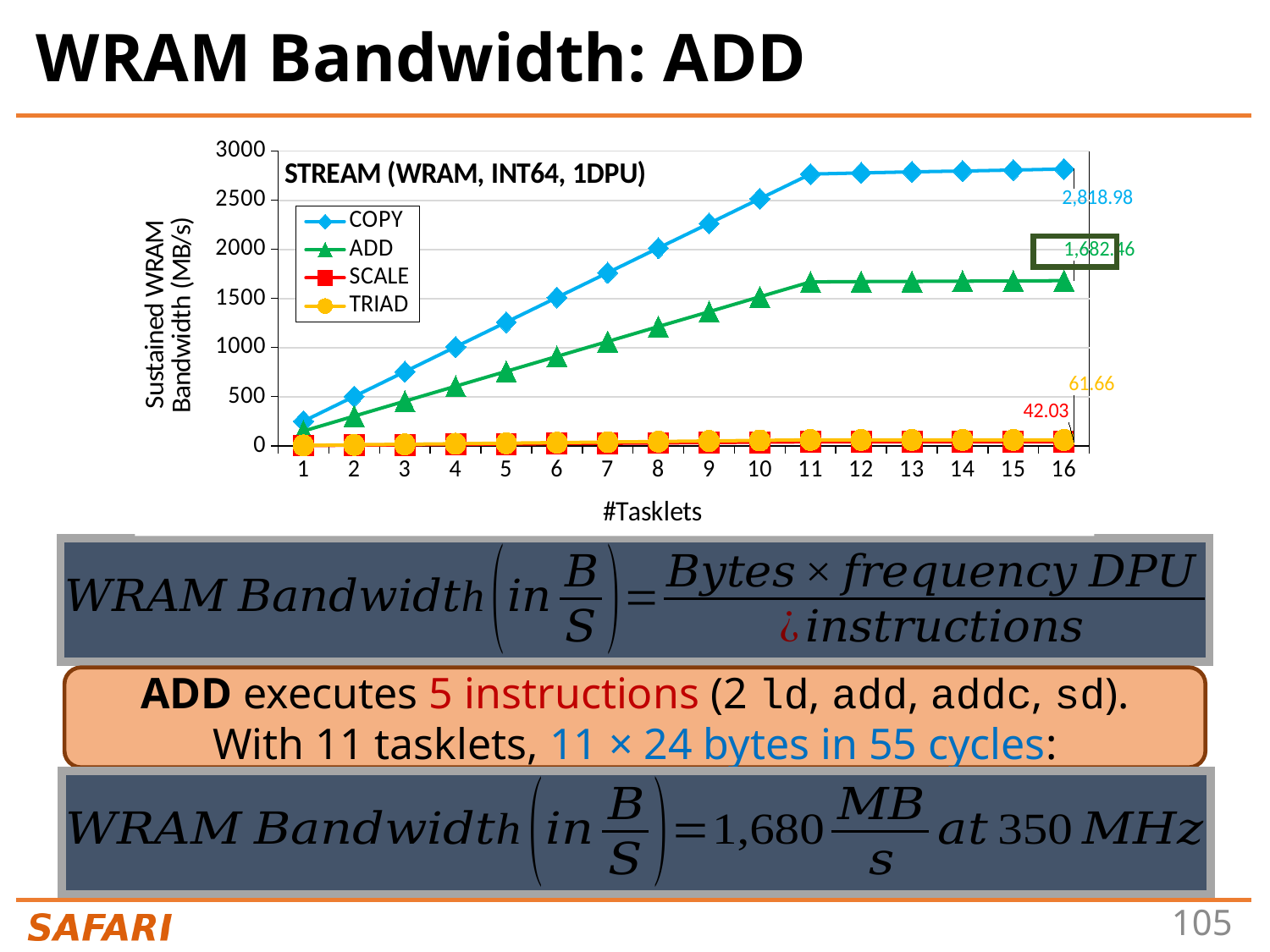
How many series does the chart legend list? 4 What is the COPY bandwidth at 16 tasklets? 2,818.98 How many tasklet counts are plotted on the x axis? 16 What is the SCALE bandwidth at 16 tasklets? 42.03 Which series has the highest bandwidth at 16 tasklets? COPY Is the COPY bandwidth at 8 tasklets greater or less than 1500? greater Which series has the lowest bandwidth at 16 tasklets? SCALE What is the difference between the COPY and ADD bandwidth at 16 tasklets? 1,136.52 What is the title shown inside the chart area? STREAM (WRAM, INT64, 1DPU) What kind of chart is shown on the slide? line chart What is the TRIAD bandwidth at 16 tasklets? 61.66 What is the ADD bandwidth at 16 tasklets? 1,682.46